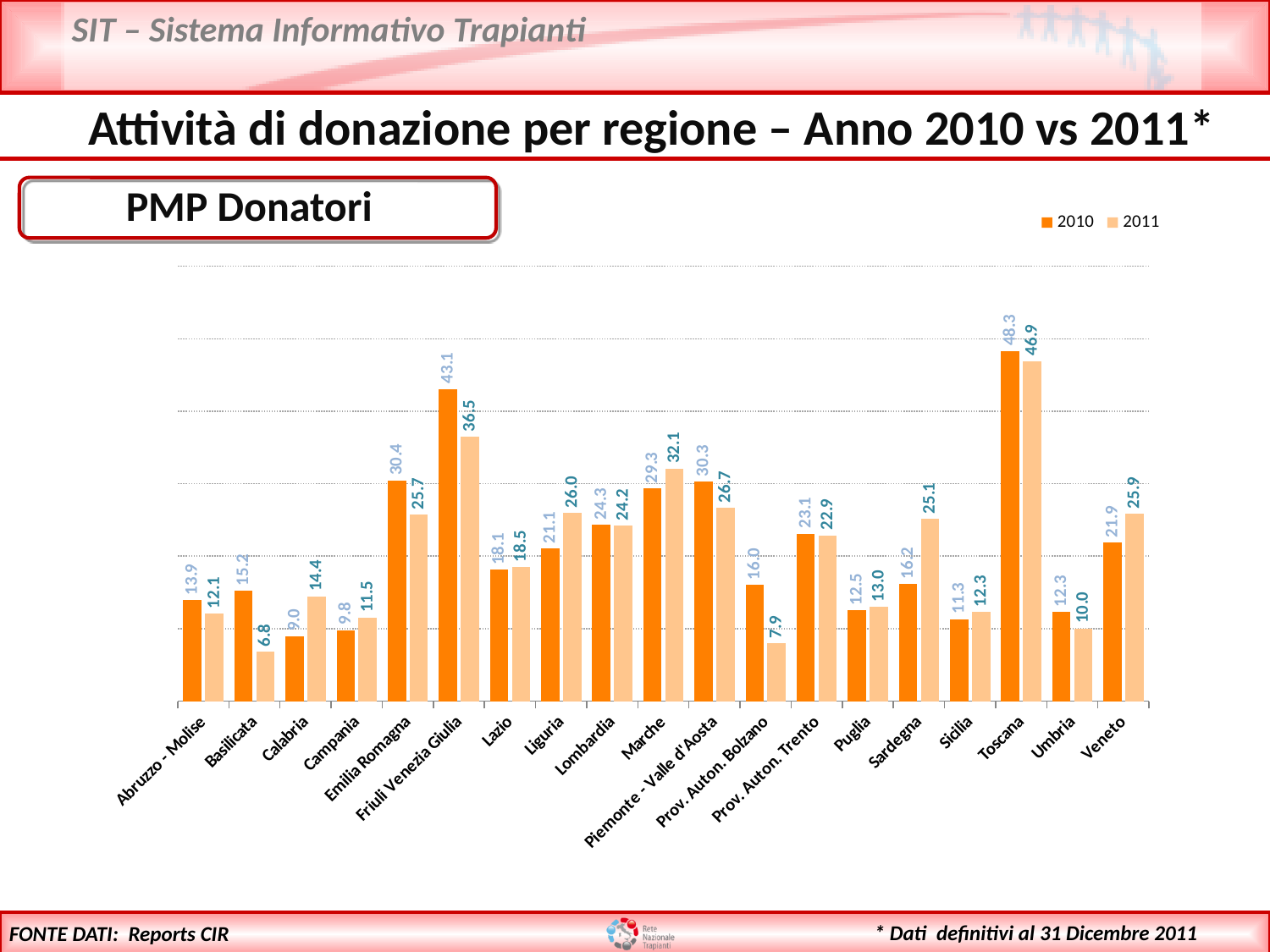
What is the difference between the 2010 and 2011 values for Basilicata? 8.4 Which is larger for Calabria, the 2010 value or the 2011 value? 2011 Which region has the highest 2010 value? Toscana What kind of chart is shown on the slide? Bar chart What is the difference between the 2011 values for Toscana and Friuli Venezia Giulia? 10.4 What is the PMP Donatori value for Friuli Venezia Giulia in 2010? 43.1 What is the 2011 value for Sardegna? 25.1 How many regions are shown on the x axis? 19 How many series does the legend list? 2 What is the PMP Donatori value for Toscana in 2011? 46.9 What is the 2010 value for Prov. Auton. Bolzano? 16.0 Which region has the lowest 2011 value? Basilicata